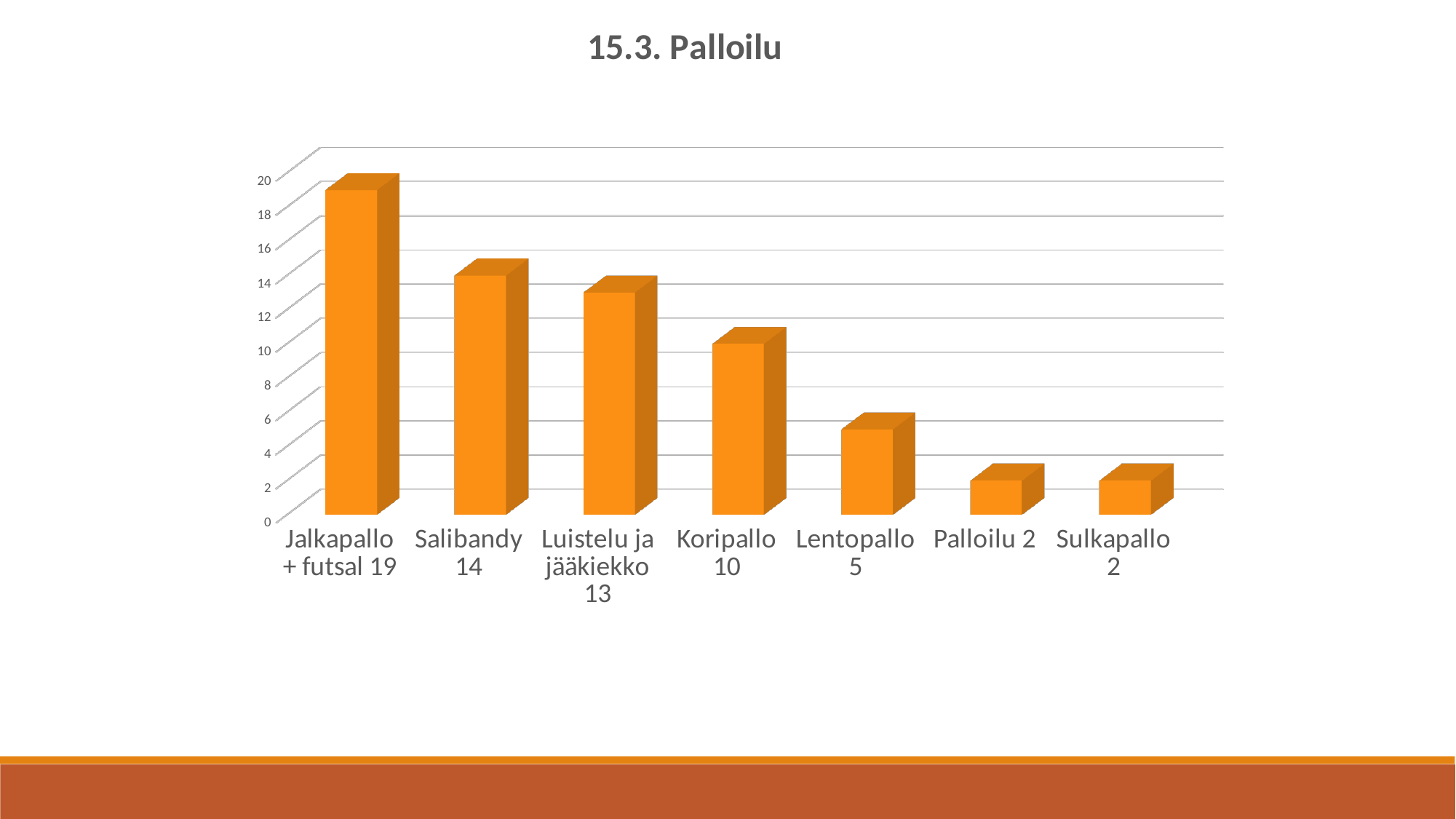
Which is larger, the value for Salibandy or the value for Lentopallo? Salibandy What kind of chart is shown on the slide? bar chart What is the title of the chart? 15.3. Palloilu What is the difference between the values for Salibandy and Luistelu ja jääkiekko? 1 How many categories are shown on the chart? 7 Which category has the highest value? Jalkapallo + futsal Is the value for Luistelu ja jääkiekko greater or less than 12? greater Do the values rise or fall from left to right along the x axis? fall What is the value for Lentopallo? 5 What is the value for Koripallo? 10 What is the value for Jalkapallo + futsal? 19 What is the difference between the values for Jalkapallo + futsal and Koripallo? 9